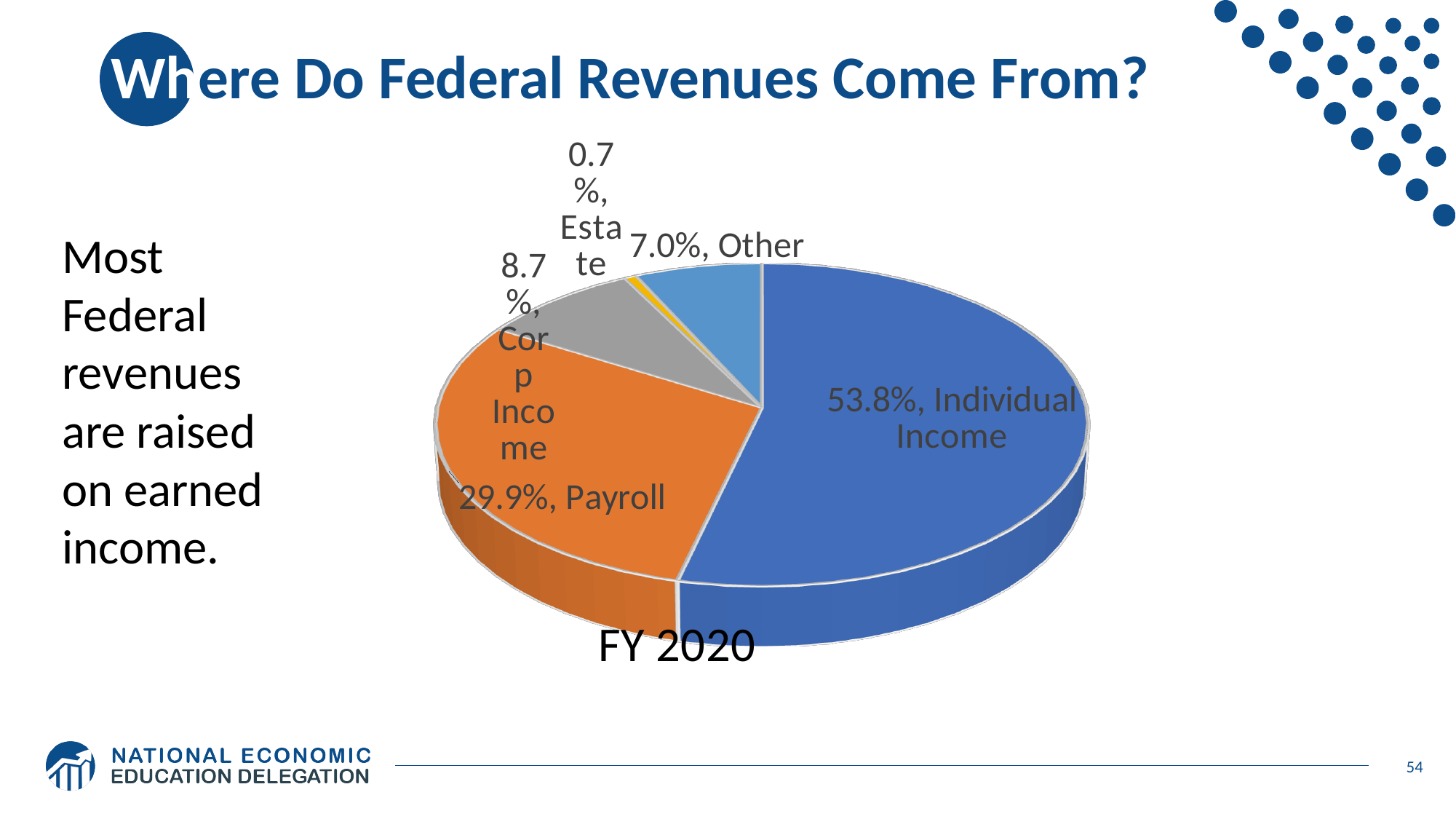
What share of federal revenues comes from Corp Income in the FY 2020 pie chart? 8.7% Which revenue source has the smallest slice in the FY 2020 pie chart? Estate Which revenue source has the largest slice in the FY 2020 pie chart? Individual Income What share of federal revenues comes from Other in the FY 2020 pie chart? 7.0% What fiscal year does the pie chart cover? FY 2020 How many slices does the FY 2020 pie chart have? 5 What share of federal revenues comes from Payroll in the FY 2020 pie chart? 29.9% What kind of chart is shown on the slide? Pie chart Which is larger in the FY 2020 pie chart, the Corp Income share or the Other share? Corp Income What share of federal revenues comes from Individual Income in the FY 2020 pie chart? 53.8% What is the difference in percentage points between the Individual Income and Payroll shares in the FY 2020 pie chart? 23.9 percentage points What share of federal revenues comes from Estate in the FY 2020 pie chart? 0.7%